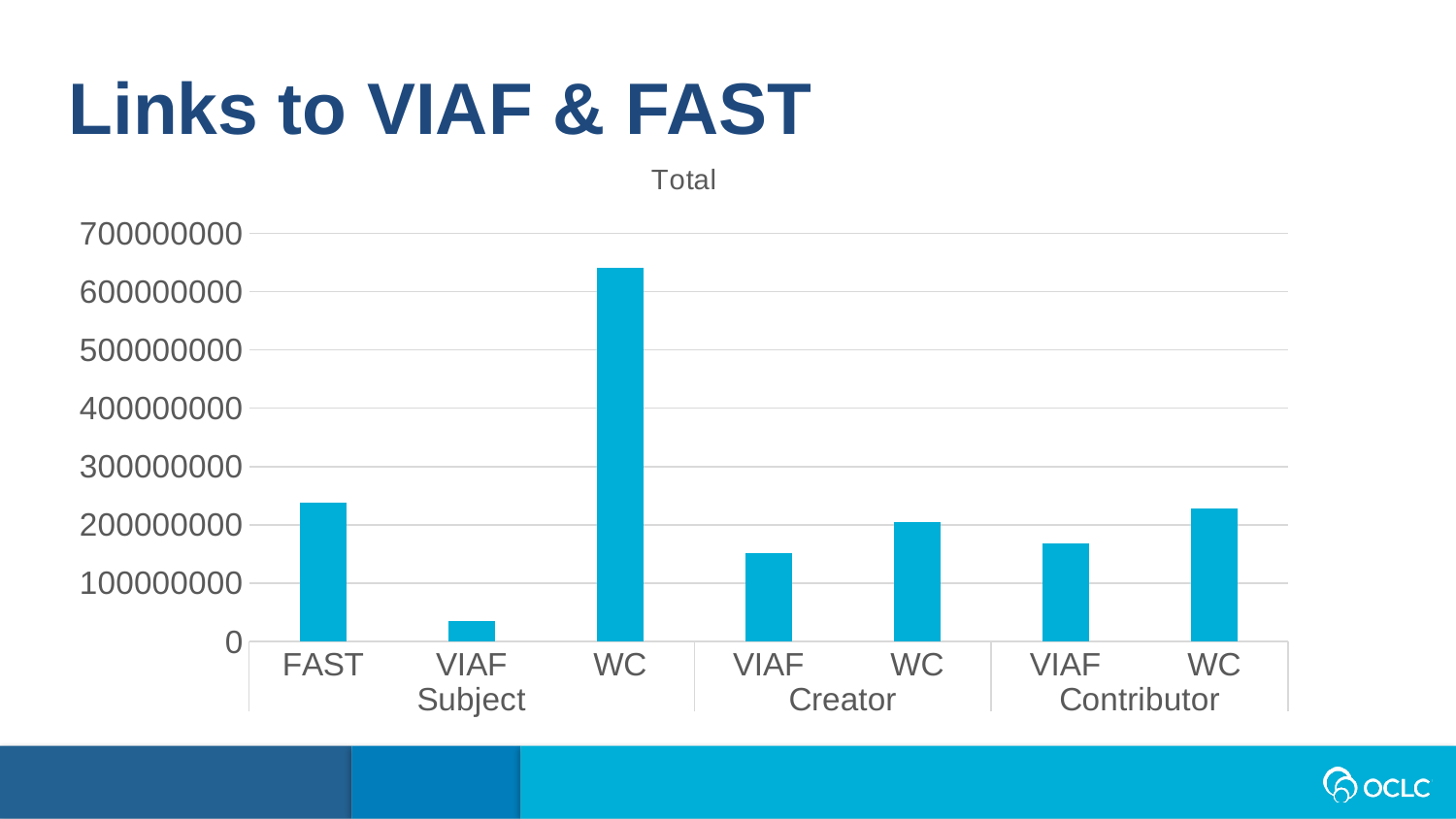
Which bar has the highest value? WC (Subject) Is the value for VIAF under Creator greater or less than 200000000? less What kind of chart is shown on the slide? bar chart How many bars are plotted in the chart? 7 What is the title of the chart? Total What is the highest value shown on the vertical axis? 700000000 Is the value for WC under Subject greater or less than 600000000? greater Is the value for VIAF under Subject greater or less than 100000000? less Which is larger, the value for VIAF under Creator or WC under Creator? WC under Creator Which bar has the lowest value? VIAF (Subject) Which is larger, the value for VIAF under Contributor or WC under Contributor? WC under Contributor